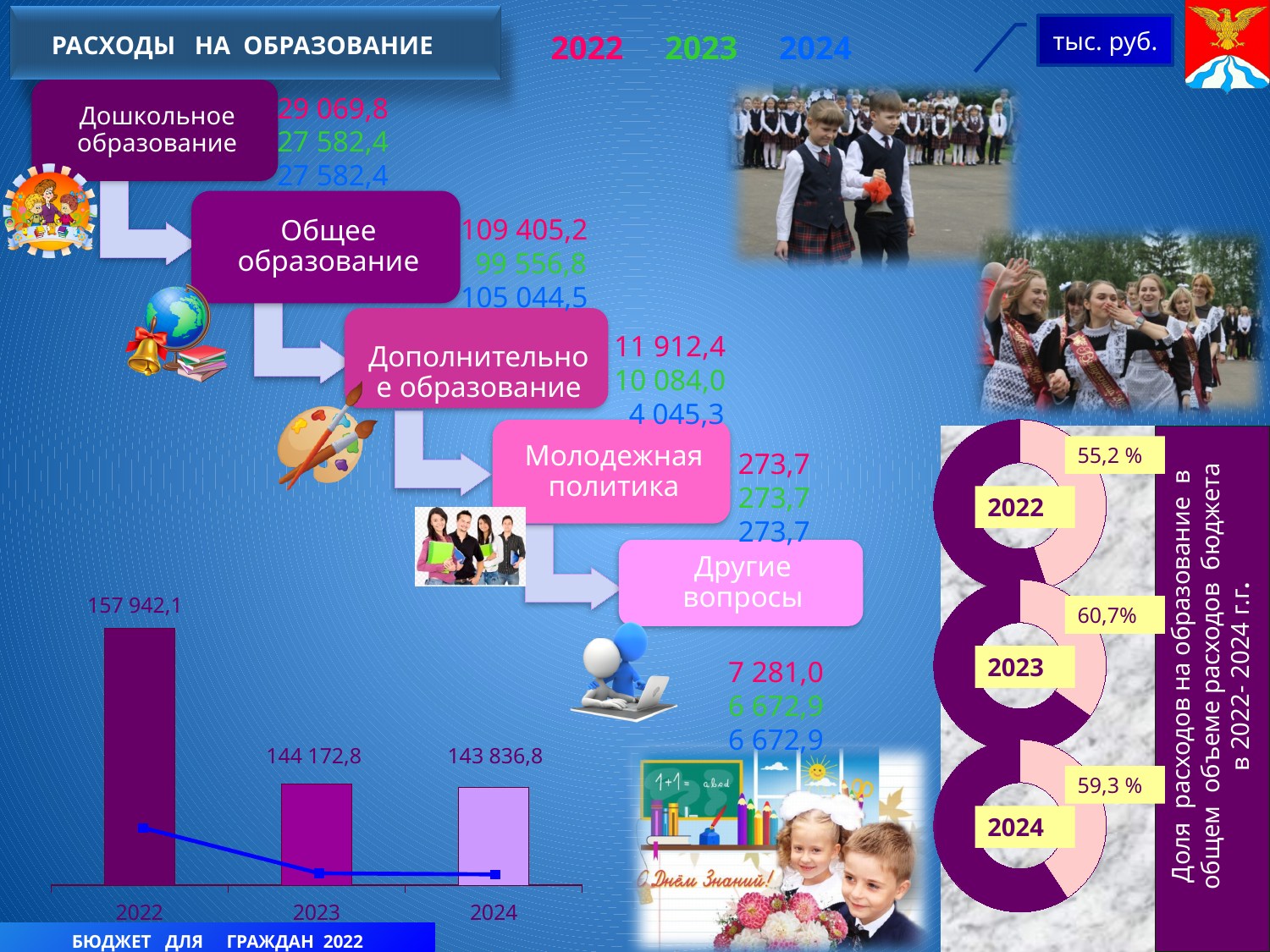
In the bar chart at the bottom left of the slide, what is the difference between the 2022 and 2023 values? 13 769,3 In the donut charts on the right of the slide (share of education spending in total budget spending), what is the share for 2022? 55,2 % In the bar chart at the bottom left of the slide, do the values rise or fall from 2022 to 2024? fall In the bar chart at the bottom left of the slide, what is the value for 2024? 143 836,8 In the donut charts on the right of the slide (share of education spending in total budget spending), what is the share for 2024? 59,3 % In the donut charts on the right of the slide, which year has the highest share of education spending? 2023 In the bar chart at the bottom left of the slide, what is the value for 2023? 144 172,8 In the bar chart at the bottom left of the slide, which year has the lowest value? 2024 In the bar chart at the bottom left of the slide, which year has the highest value? 2022 In the bar chart at the bottom left of the slide, how many years are shown on the x axis? 3 In the bar chart at the bottom left of the slide, what is the value for 2022? 157 942,1 What kind of chart is shown at the bottom left of the slide? bar chart